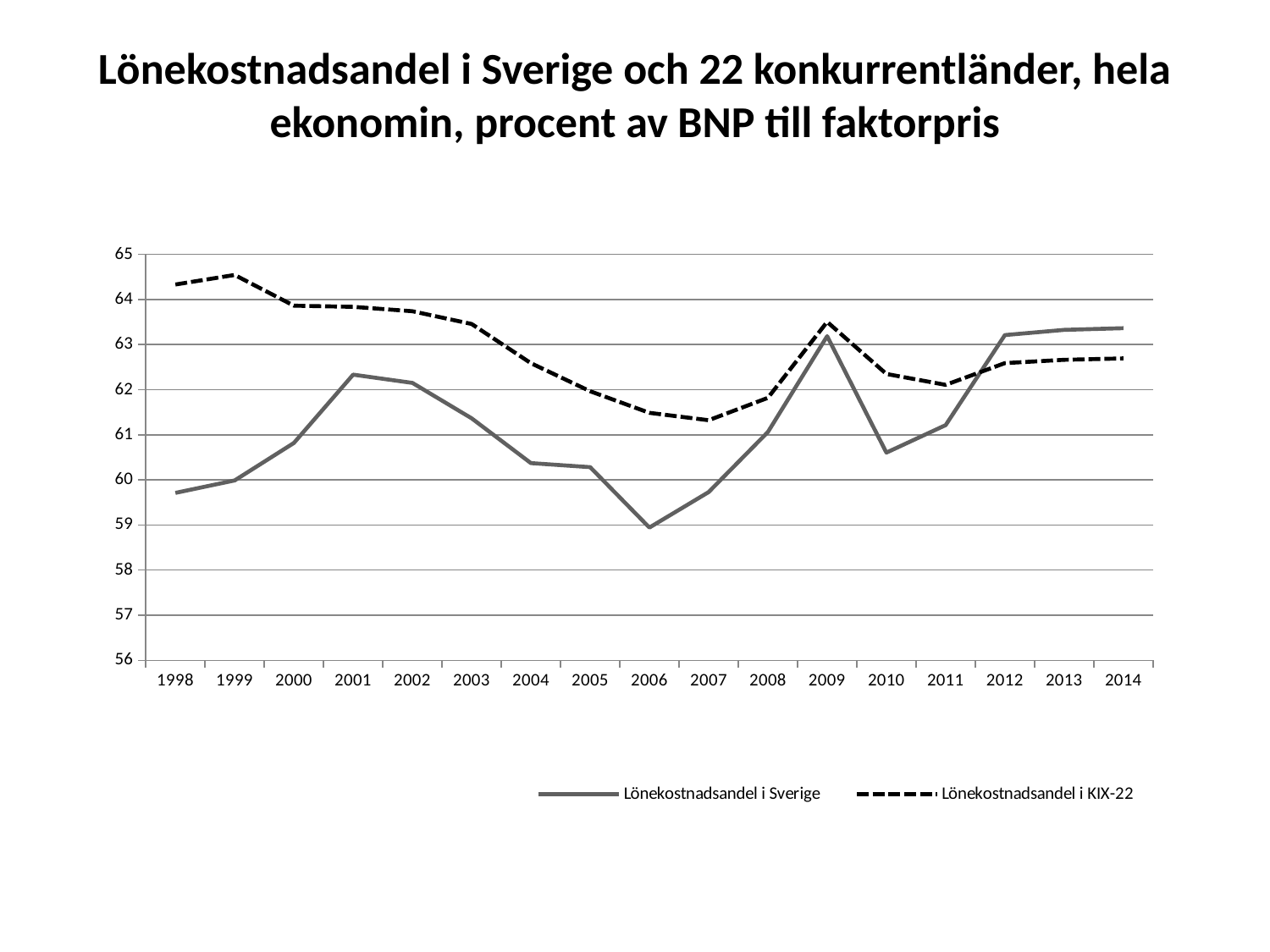
Does the value for Lönekostnadsandel i KIX-22 rise or fall from 1999 to 2007? fall How many series does the legend list? 2 Which series is drawn with a dashed line? Lönekostnadsandel i KIX-22 How many years are plotted along the x axis? 17 In which year is the value for Lönekostnadsandel i Sverige lowest? 2006 In which year is the value for Lönekostnadsandel i KIX-22 highest? 1999 Is the value for Lönekostnadsandel i Sverige in 2001 greater or less than 62? greater Is the value for Lönekostnadsandel i KIX-22 in 1998 greater or less than 64? greater What kind of chart is shown on the slide? line chart In 2003, which series has the higher value, Lönekostnadsandel i Sverige or Lönekostnadsandel i KIX-22? Lönekostnadsandel i KIX-22 In 2012, which series has the higher value, Lönekostnadsandel i Sverige or Lönekostnadsandel i KIX-22? Lönekostnadsandel i Sverige